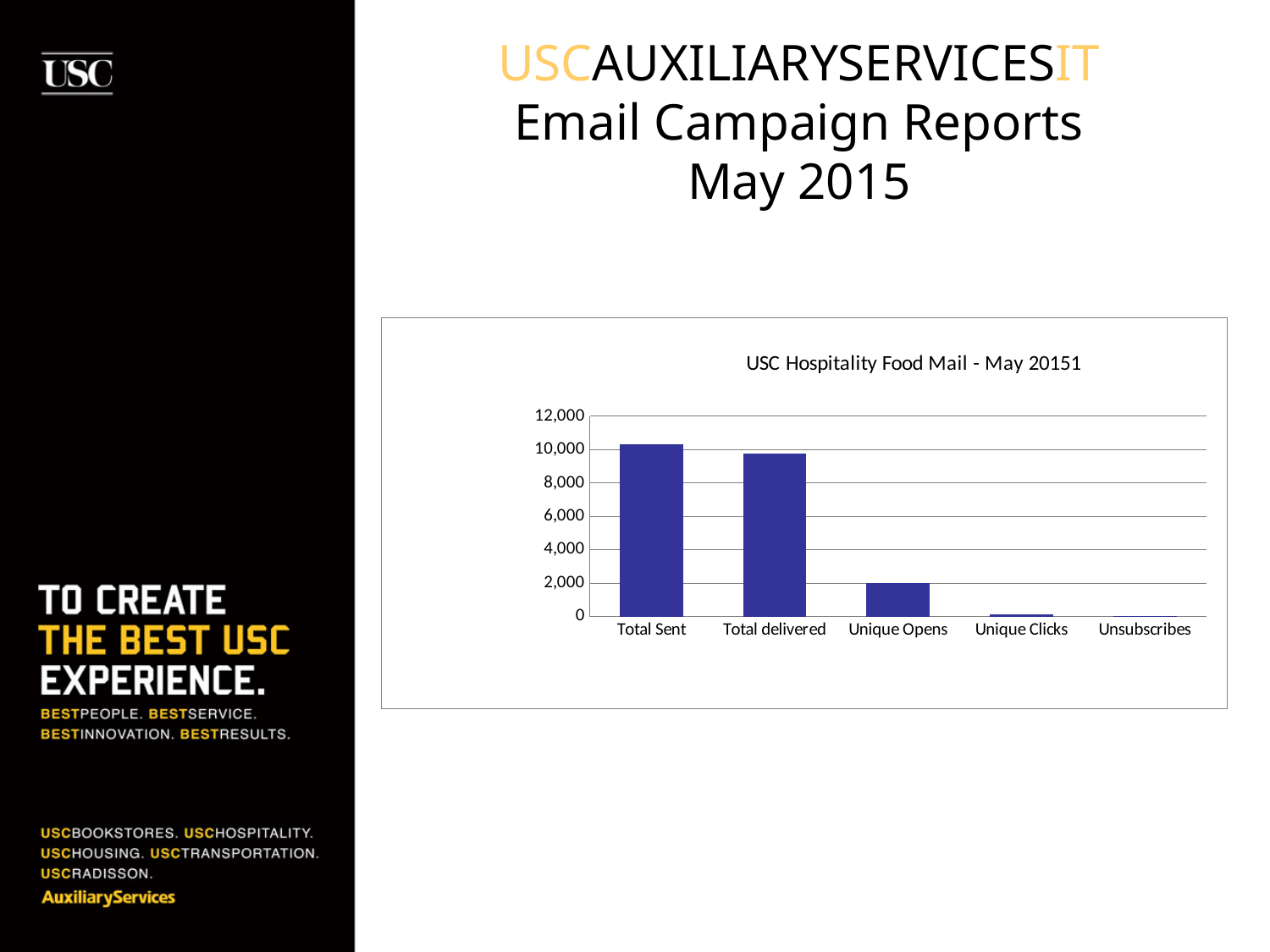
Which is larger, Unique Opens or Unique Clicks? Unique Opens How many categories are plotted in the chart? 5 Is the value for Total Sent greater or less than 8,000? greater What is the title of the chart? USC Hospitality Food Mail - May 20151 What kind of chart is shown on the slide? bar chart Is the value for Unique Clicks greater or less than 2,000? less Which category has the lowest value in the chart? Unsubscribes Do the values rise or fall moving from left to right along the x axis? fall Is the value for Total delivered greater or less than 8,000? greater Which category has the highest value in the chart? Total Sent Which is larger, Total Sent or Total delivered? Total Sent